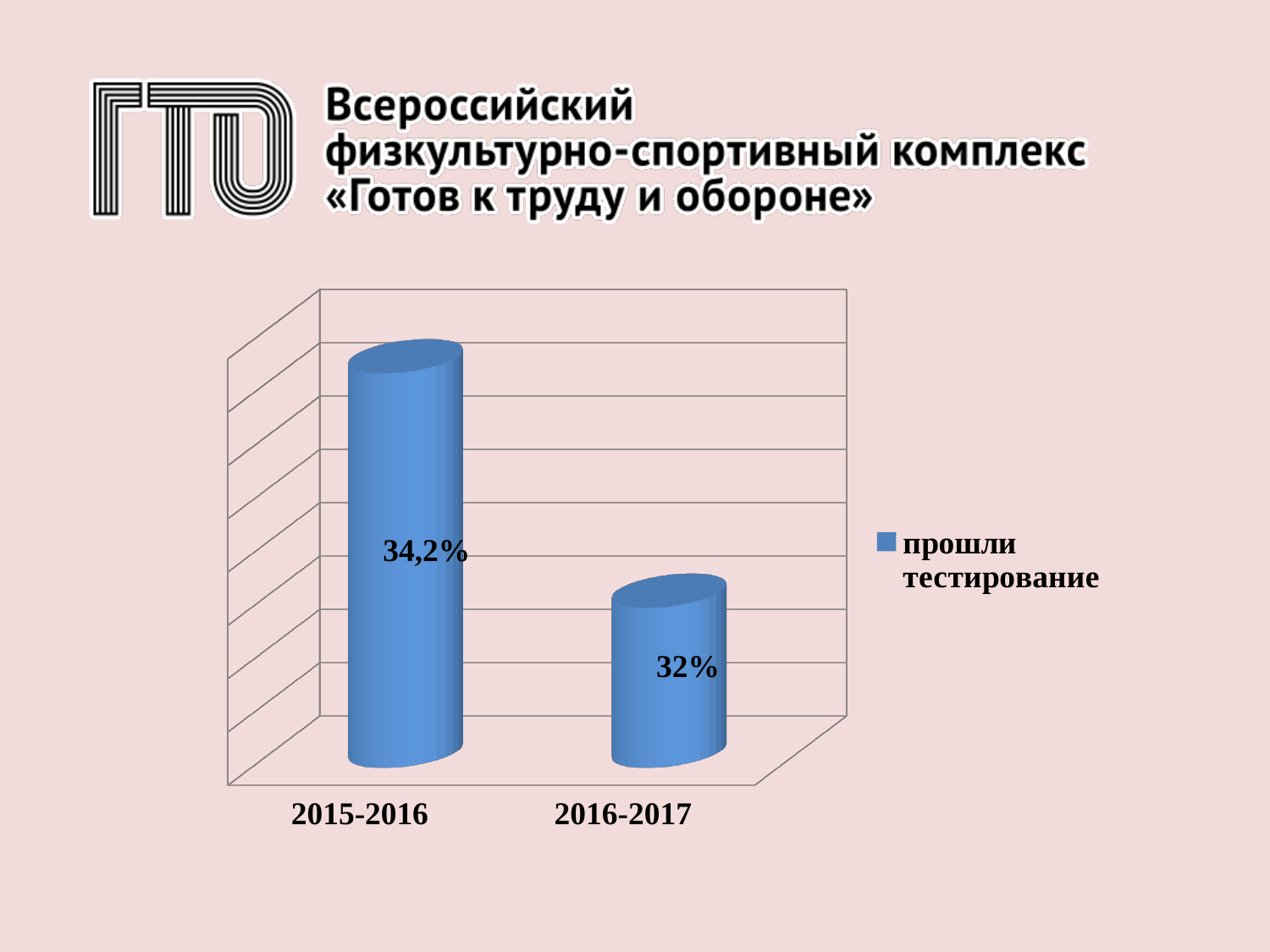
Which is larger, the value for 2015-2016 or the value for 2016-2017? 2015-2016 Which category has the lowest value? 2016-2017 What is the value for 2015-2016? 34,2% What colour are the bars in the chart? blue How many categories are shown on the x axis? 2 Do the values rise or fall from 2015-2016 to 2016-2017? fall Which category has the highest value? 2015-2016 What is the value for 2016-2017? 32% What kind of chart is shown on the slide? bar chart What is the name of the series shown in the legend? прошли тестирование How many series does the legend list? 1 What is the difference between the values for 2015-2016 and 2016-2017? 2,2%